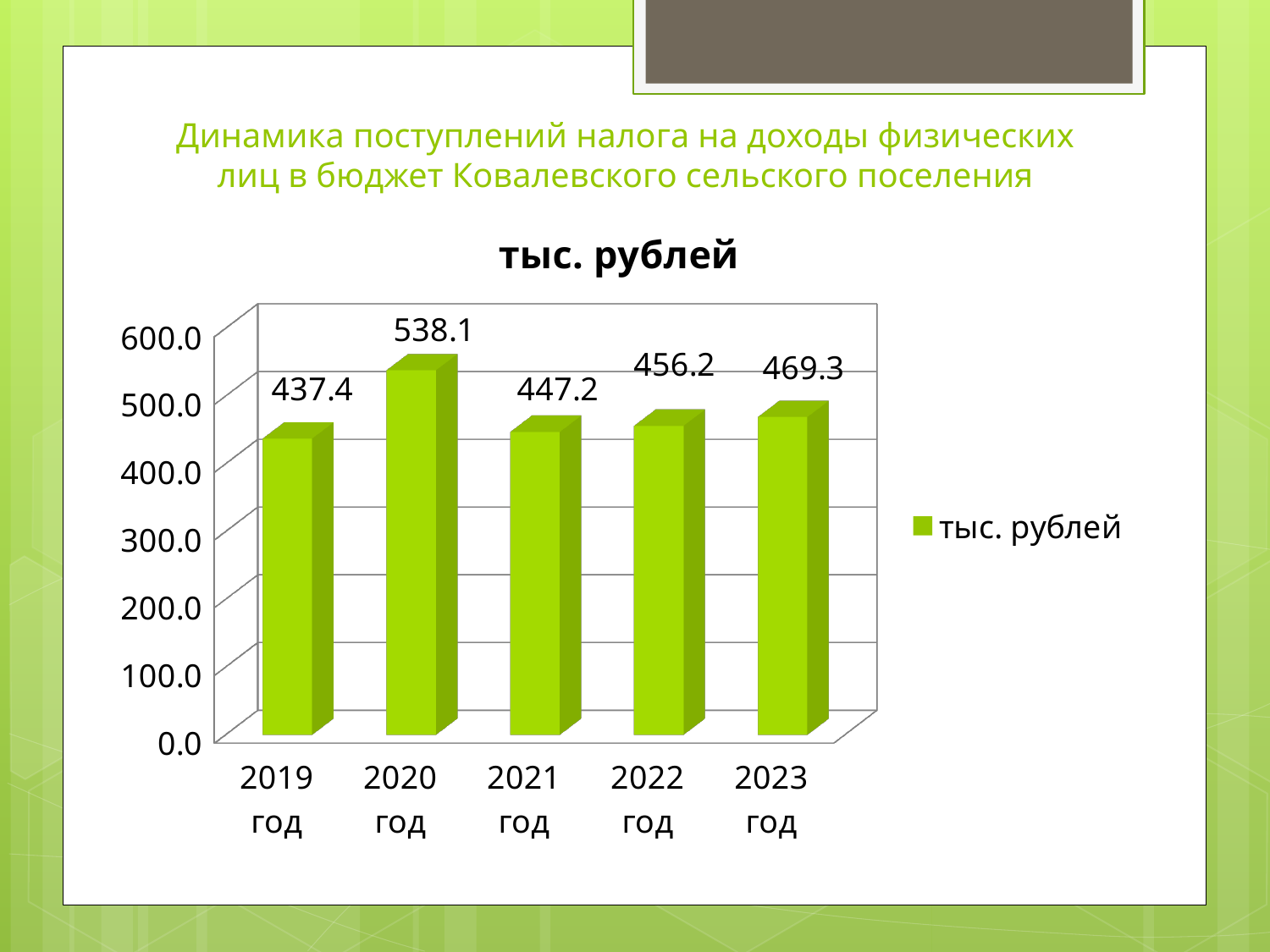
What is the difference between the values for 2020 год and 2019 год? 100.7 How many years are shown on the x axis? 5 What is the value for 2020 год? 538.1 Is the value for 2021 год greater or less than 500.0? less What kind of chart is shown on the slide? bar chart What is the title of the chart? тыс. рублей What is the value for 2023 год? 469.3 Which is larger, the value for 2021 год or the value for 2022 год? 2022 год Which year has the highest value? 2020 год What is the difference between the values for 2023 год and 2022 год? 13.1 What is the value for 2019 год? 437.4 Which year has the lowest value? 2019 год